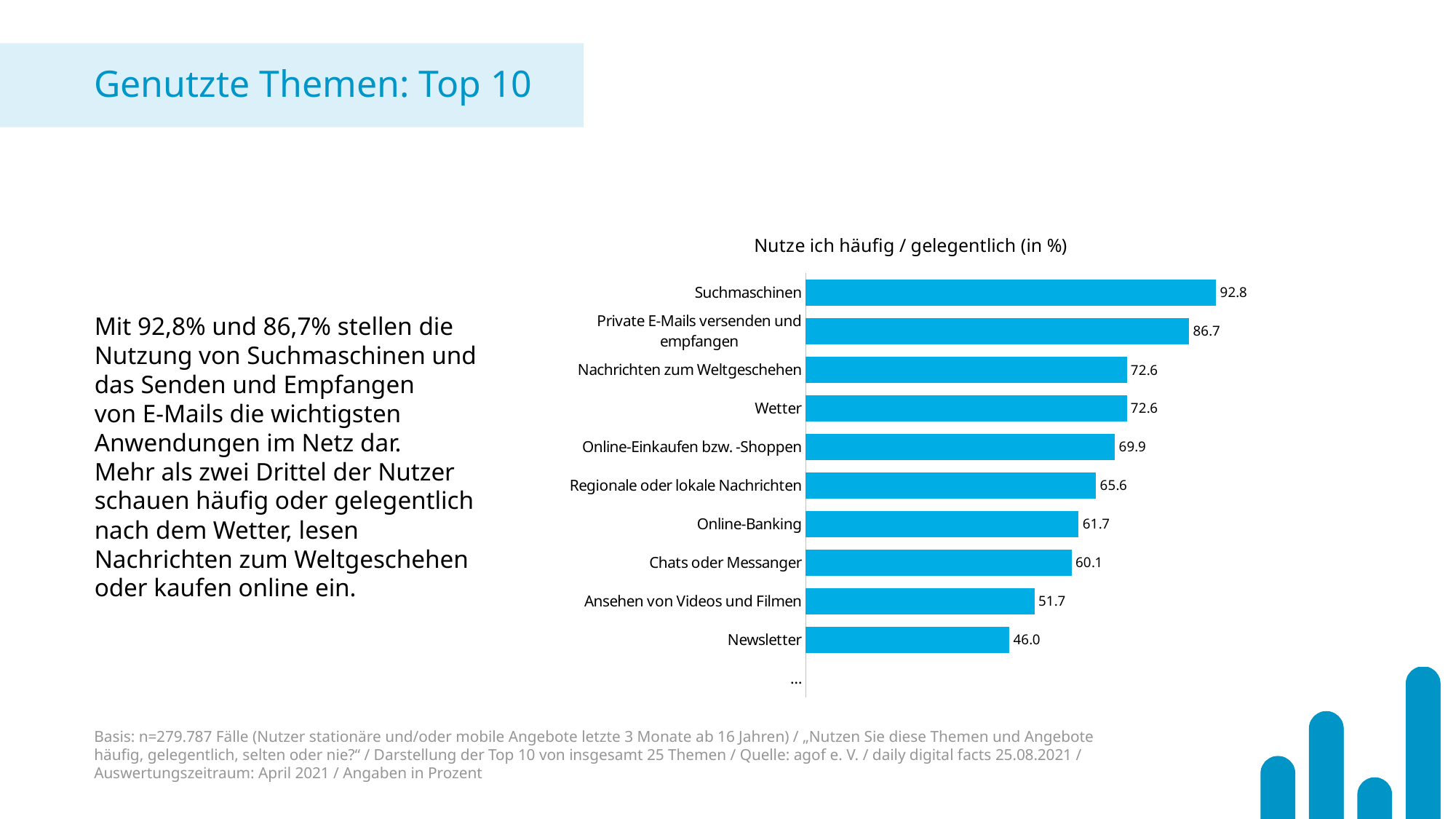
What is the difference between the values for Suchmaschinen and Private E-Mails versenden und empfangen? 6.1 What is the value for Suchmaschinen? 92.8 What kind of chart is shown on the slide? Bar chart What is the title of the chart? Nutze ich häufig / gelegentlich (in %) What is the value for Online-Banking? 61.7 Which is larger, the value for Regionale oder lokale Nachrichten or the value for Chats oder Messanger? Regionale oder lokale Nachrichten Which category has the highest value? Suchmaschinen Which category has the lowest value among the bars shown? Newsletter What is the difference between the values for Online-Einkaufen bzw. -Shoppen and Newsletter? 23.9 How many labelled bars are plotted in the chart? 10 What is the value for Ansehen von Videos und Filmen? 51.7 What is the value for Newsletter? 46.0